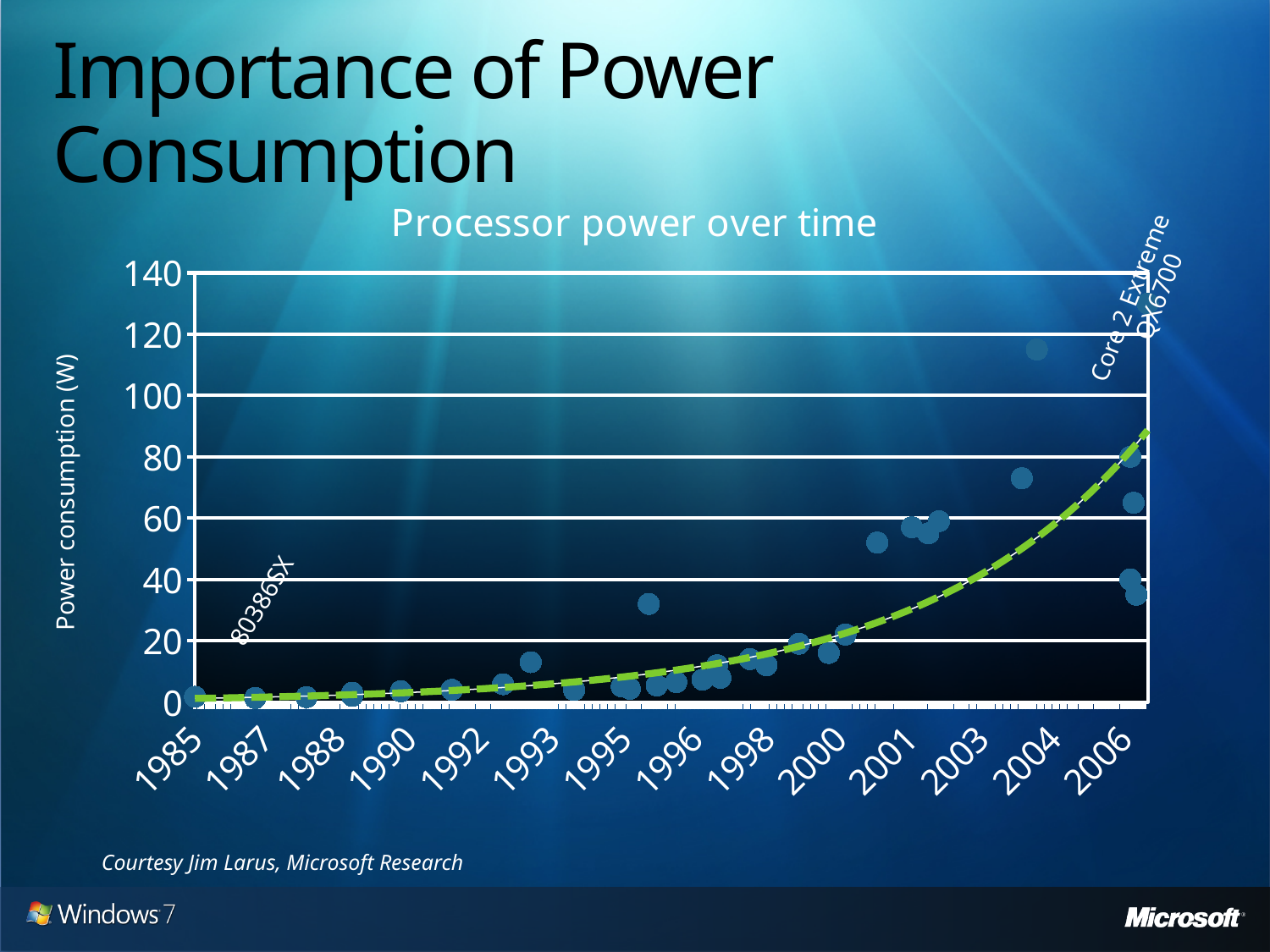
Are the plotted values around 1992 greater or less than 20 W? less Is the highest plotted point on the chart greater or less than 100 W? greater Do the plotted power consumption values generally rise or fall as the years increase along the x axis? Rise What is the highest value shown on the vertical axis? 140 Which year is the last label on the horizontal axis? 2006 What is the title of the chart? Processor power over time What is the label of the vertical axis? Power consumption (W) Are the plotted values around 2001 greater or less than 40 W? greater Which year is the first label on the horizontal axis? 1985 What kind of chart is shown on the slide? Scatter chart